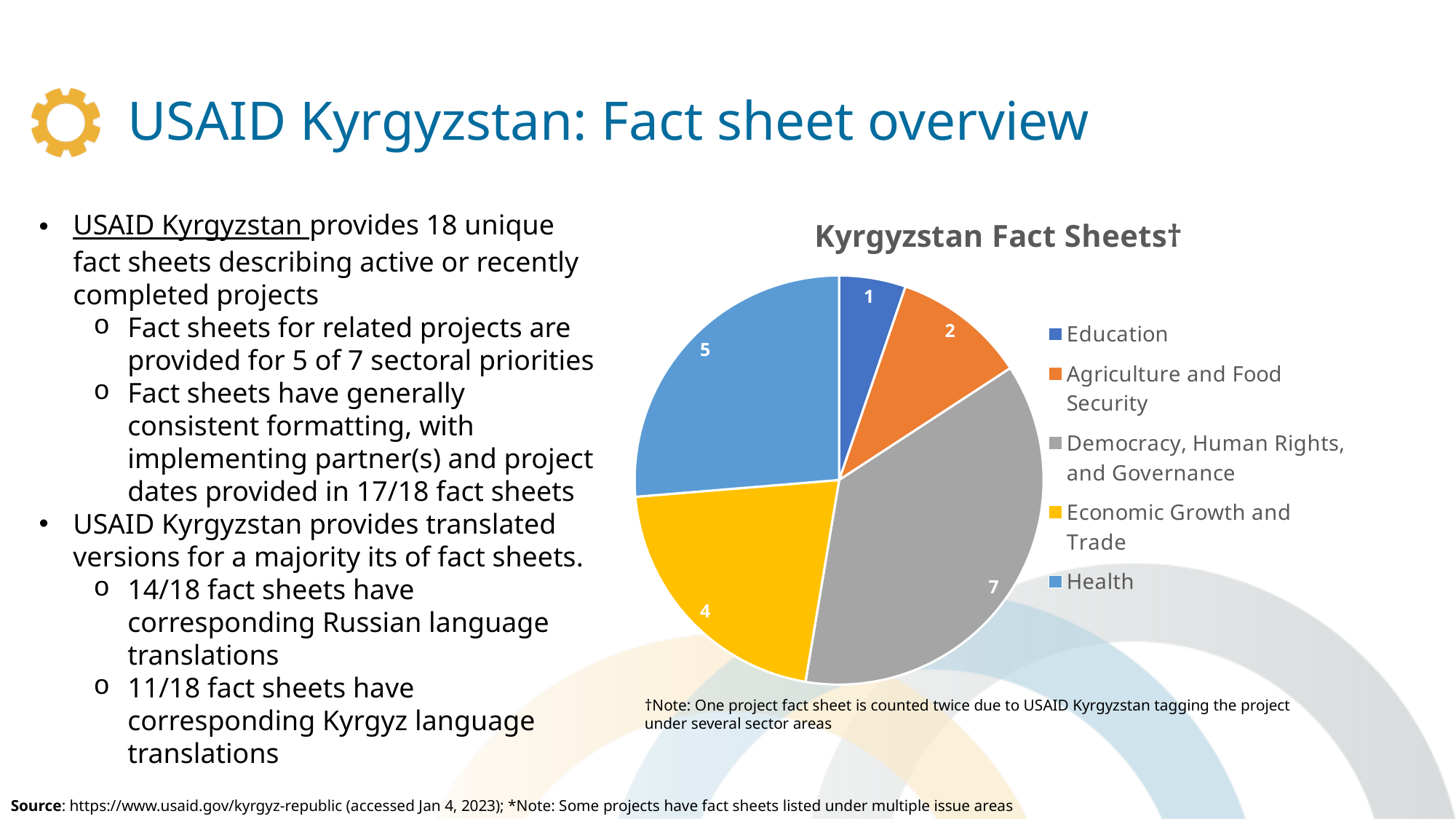
How many fact sheets are shown for Agriculture and Food Security? 2 How many fact sheets are shown for Education? 1 How many fact sheets are shown for Health? 5 What is the title of the chart? Kyrgyzstan Fact Sheets† How many fact sheets are shown for Economic Growth and Trade? 4 Which has more fact sheets, Economic Growth and Trade or Agriculture and Food Security? Economic Growth and Trade Which sector has the smallest slice of the pie? Education What is the difference between the number of fact sheets for Democracy, Human Rights, and Governance and for Health? 2 What type of chart is shown on the slide? Pie chart How many fact sheets are shown for Democracy, Human Rights, and Governance? 7 How many sectors does the legend list? 5 Which sector has the largest slice of the pie? Democracy, Human Rights, and Governance